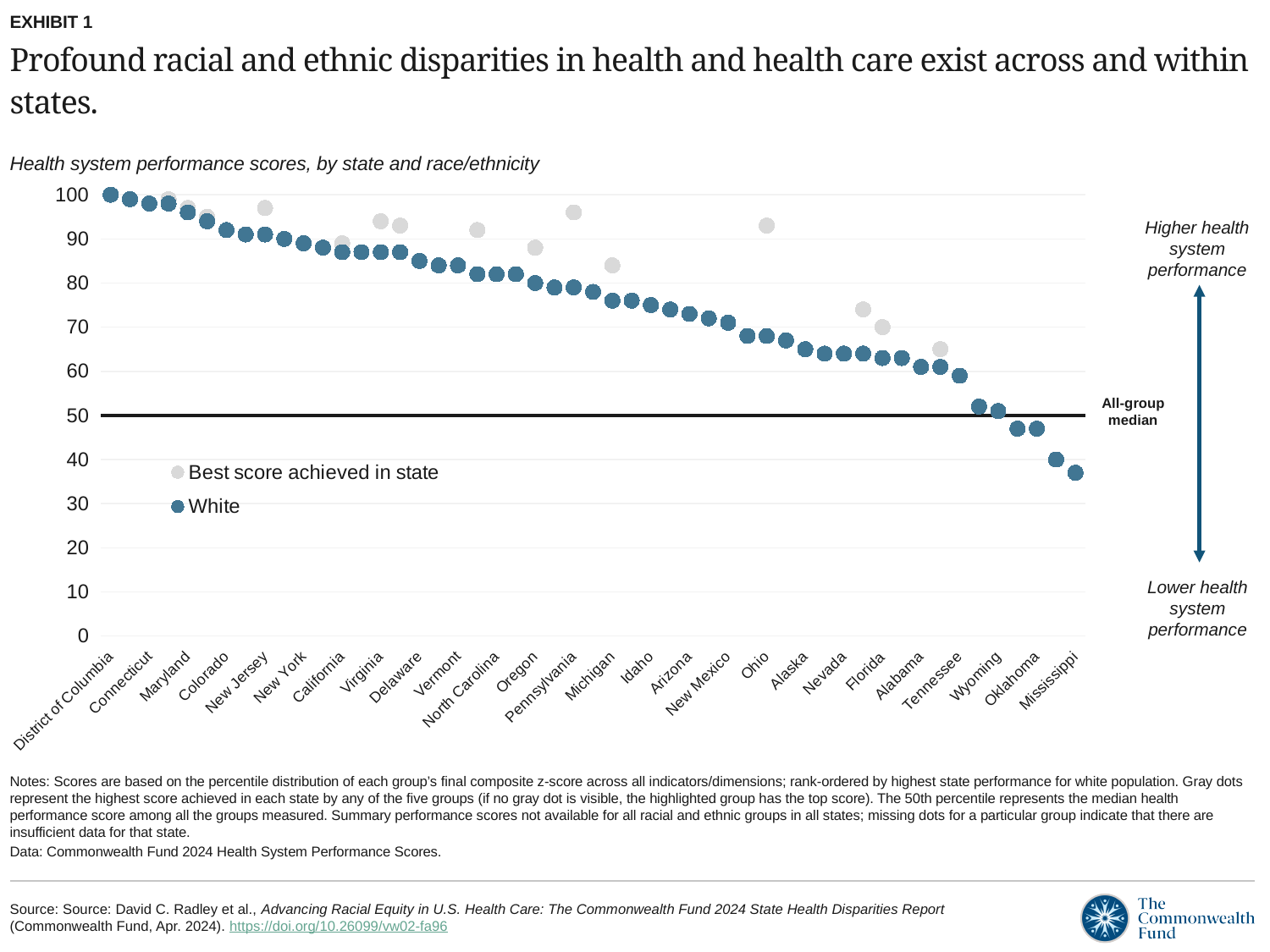
Which state has the highest White health system performance score? District of Columbia Is the White score for Oklahoma greater or less than 50? less Do the White scores rise or fall moving from left to right along the x axis? Fall How many series does the chart legend list? 2 Is the White score for Colorado greater or less than 90? greater Which has the larger White score, District of Columbia or Mississippi? District of Columbia Which series is shown with gray dots in the legend? Best score achieved in state Which state has the lowest White health system performance score? Mississippi Is the White score for Michigan greater or less than 70? greater At what score is the All-group median line drawn? 50 What kind of chart is shown on the slide? Dot (scatter) chart